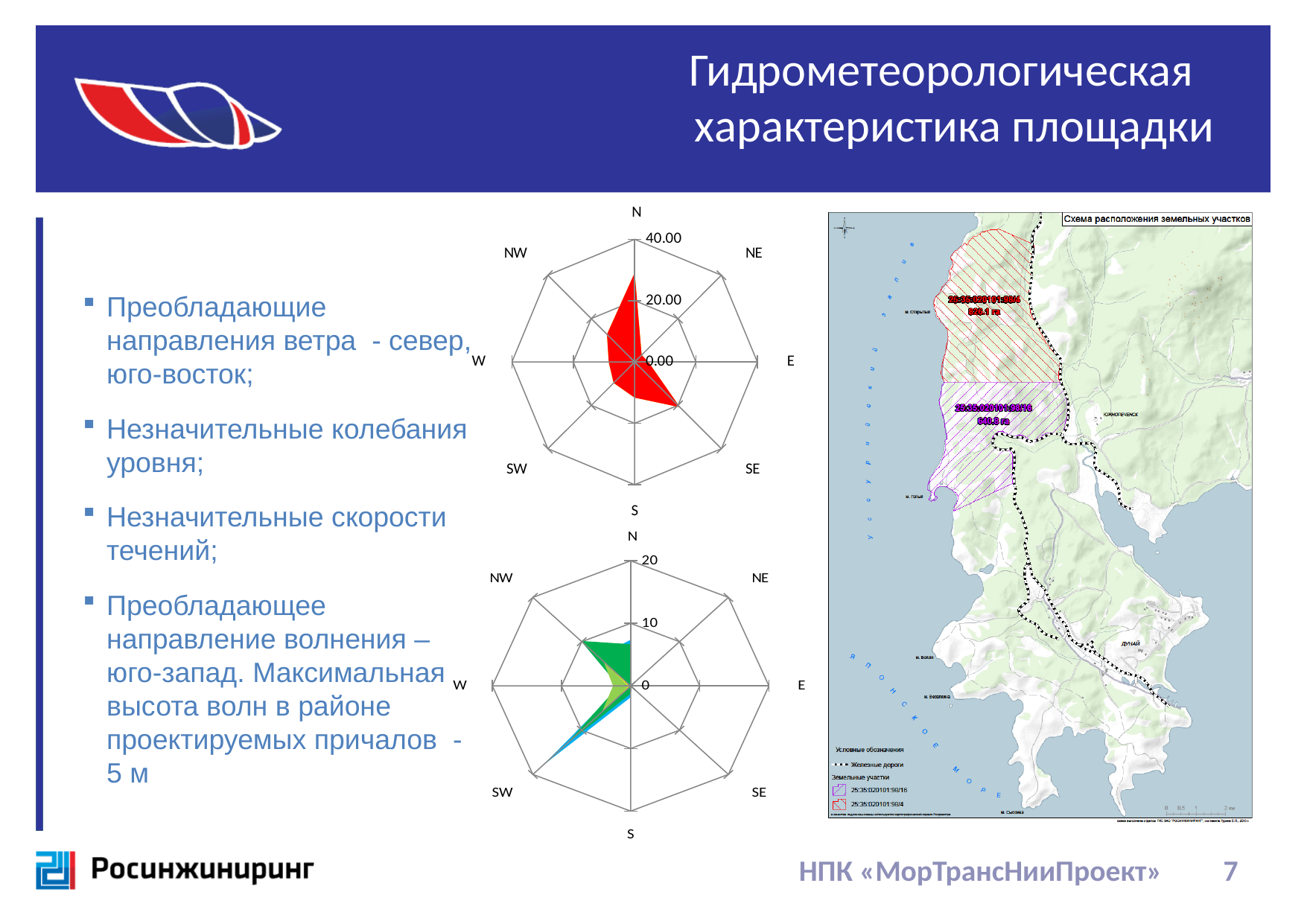
In the lower radar chart, which direction has the highest value? SW In the upper radar chart, how many direction categories are plotted around the axis? 8 In the upper radar chart, is the value for W greater or less than 20.00? less In the lower radar chart, how many direction categories are plotted around the axis? 8 In the lower radar chart, is the value for SW greater or less than 10? greater What kind of chart is the lower chart in the middle of the slide? Radar chart In the lower radar chart, is the value for E greater or less than 10? less What is the outermost axis tick label shown on the upper radar chart? 40.00 What kind of chart is the upper chart in the middle of the slide? Radar chart In the upper radar chart, which is larger, the value for N or the value for W? N In the upper radar chart, which direction has the highest value? N